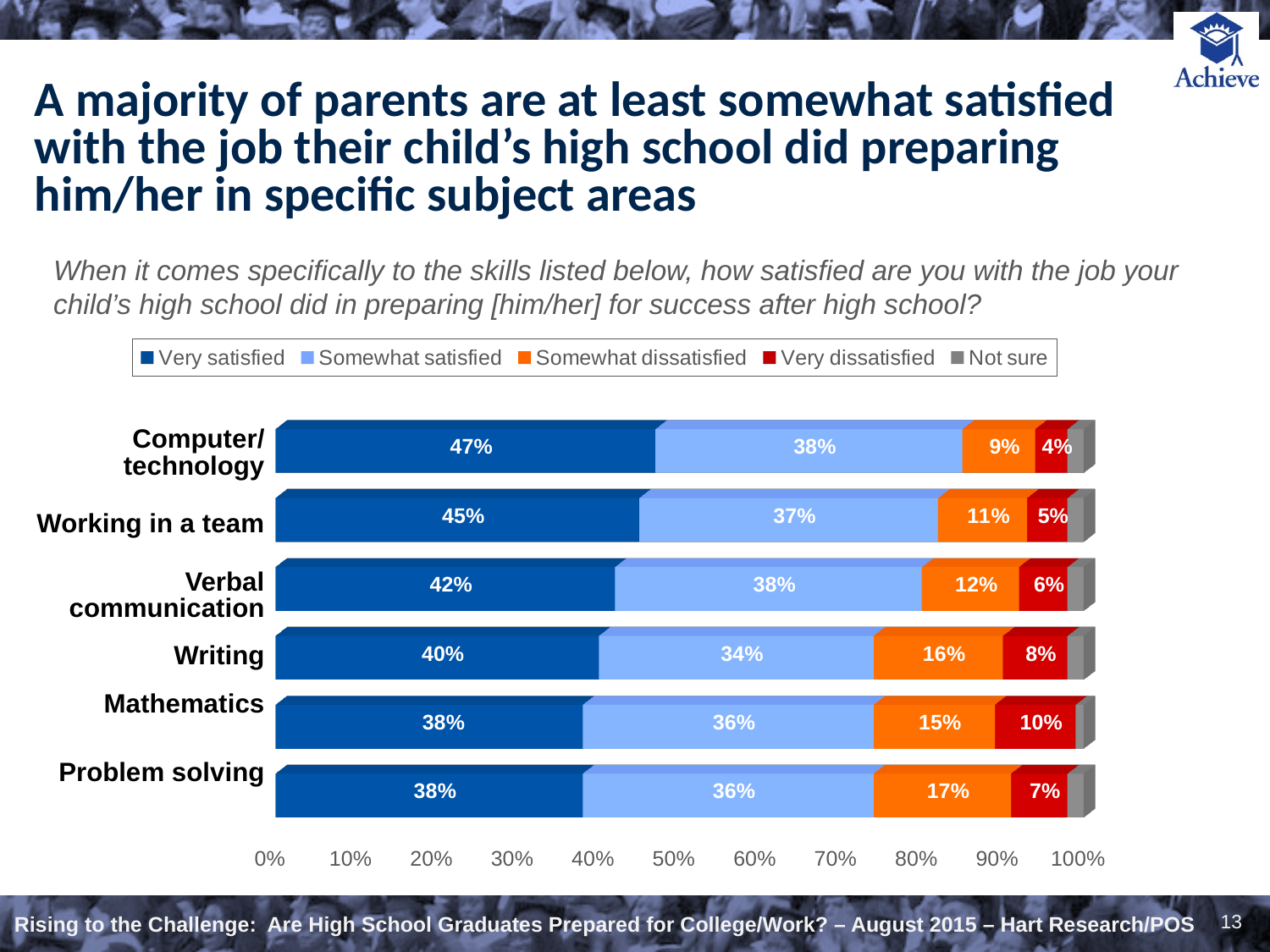
What kind of chart is shown on the slide? Stacked bar chart Which skill has the lowest share of parents who are somewhat satisfied? Writing What percentage of parents are very satisfied with preparation in Computer/technology? 47% What percentage of parents are very dissatisfied with preparation in Mathematics? 10% Which skill has the highest share of parents who are very dissatisfied? Mathematics How many skill categories are plotted in the chart? 6 Which has a larger somewhat dissatisfied percentage, Writing or Verbal communication? Writing What colour represents the Somewhat dissatisfied series in the chart? Orange What is the difference between the very satisfied percentages for Computer/technology and Writing? 7% Which skill has the highest share of parents who are very satisfied? Computer/technology What percentage of parents are somewhat dissatisfied with preparation in Problem solving? 17% How many series does the legend list? 5